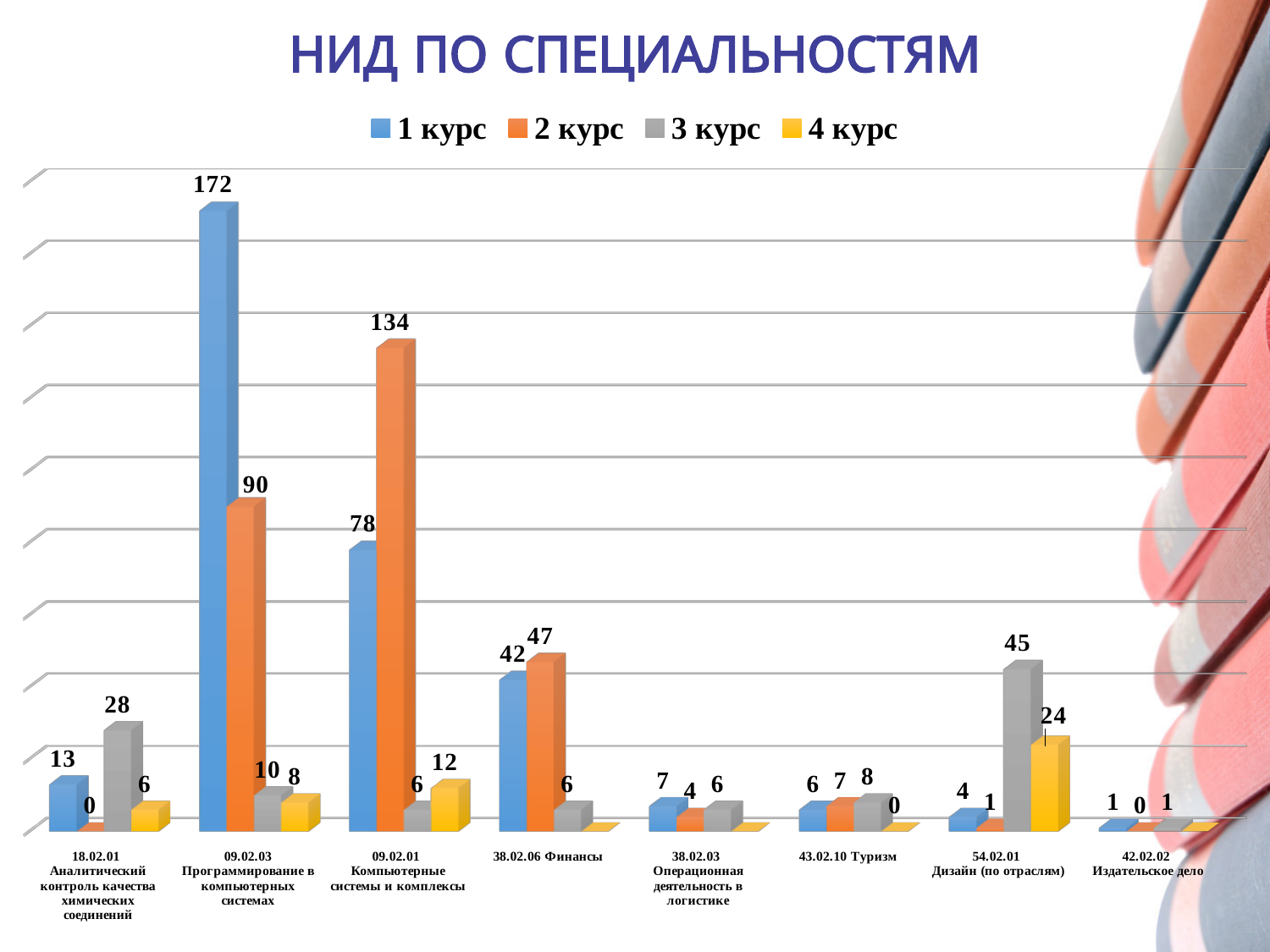
What kind of chart is shown on the slide? Bar chart Which specialty has the highest value for 3 курс? 54.02.01 Дизайн (по отраслям) How many series does the legend list? 4 What is the value for 3 курс in the 54.02.01 Дизайн (по отраслям) category? 45 What is the difference between the 1 курс and 2 курс values in the 09.02.03 Программирование в компьютерных системах category? 82 What is the value for 1 курс in the 09.02.03 Программирование в компьютерных системах category? 172 What is the value for 2 курс in the 09.02.01 Компьютерные системы и комплексы category? 134 Which specialty has the highest value for 1 курс? 09.02.03 Программирование в компьютерных системах What is the difference between the 2 курс and 1 курс values in the 09.02.01 Компьютерные системы и комплексы category? 56 In the 38.02.06 Финансы category, which is larger: 1 курс or 2 курс? 2 курс What is the value for 4 курс in the 54.02.01 Дизайн (по отраслям) category? 24 How many specialty categories are shown on the x axis? 8